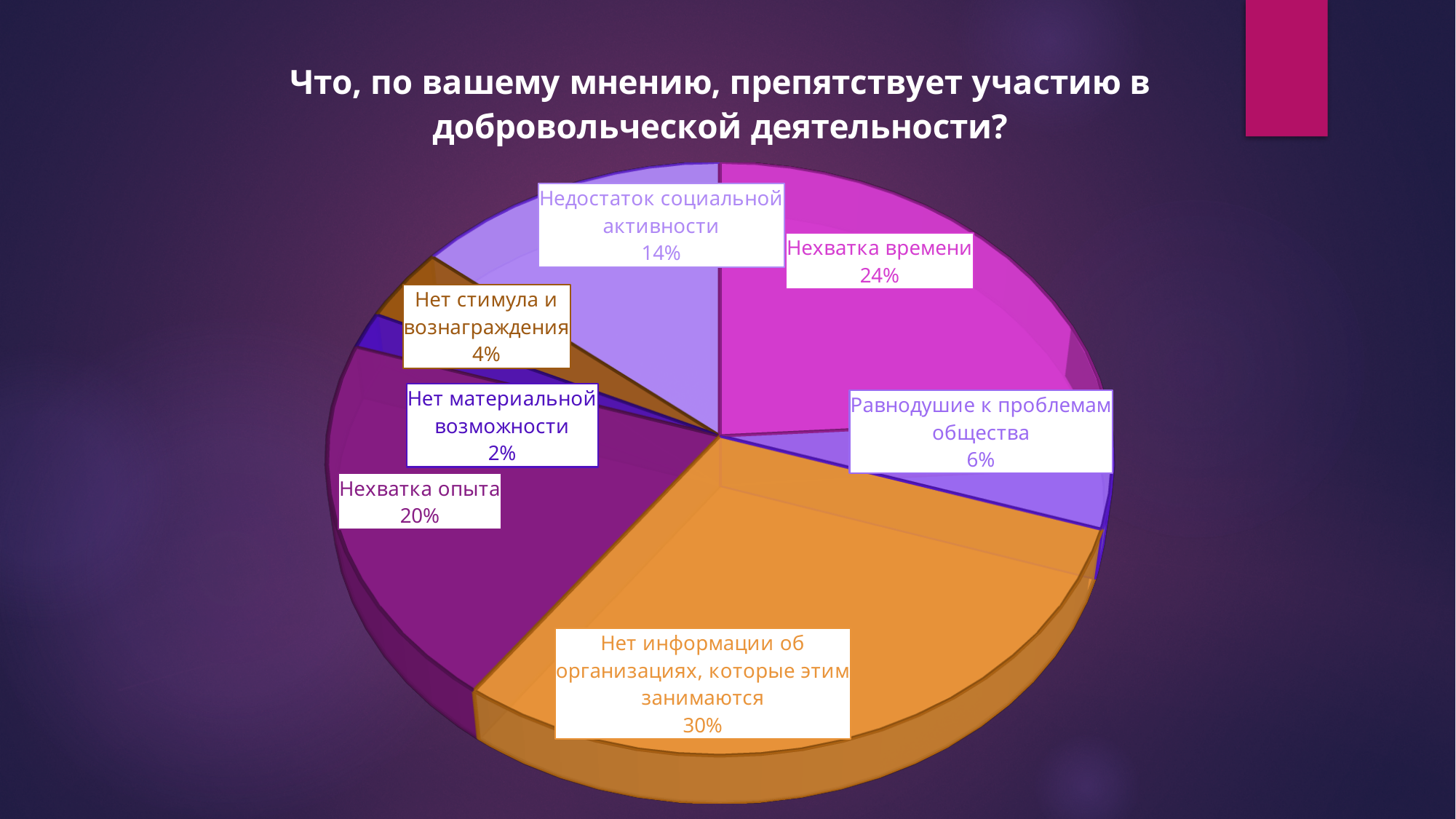
Which category has the largest share of the pie? Нет информации об организациях, которые этим занимаются What is the value for "Нехватка времени"? 24% Which category has the smallest share of the pie? Нет материальной возможности What is the value for "Нехватка опыта"? 20% What is the value for "Нет информации об организациях, которые этим занимаются"? 30% What is the difference between "Нехватка времени" and "Нехватка опыта"? 4% What is the title of the chart? Что, по вашему мнению, препятствует участию в добровольческой деятельности? Which is larger: "Недостаток социальной активности" or "Равнодушие к проблемам общества"? Недостаток социальной активности What is the value for "Недостаток социальной активности"? 14% How many categories does the pie chart have? 7 What type of chart is shown on the slide? Pie chart What is the value for "Равнодушие к проблемам общества"? 6%